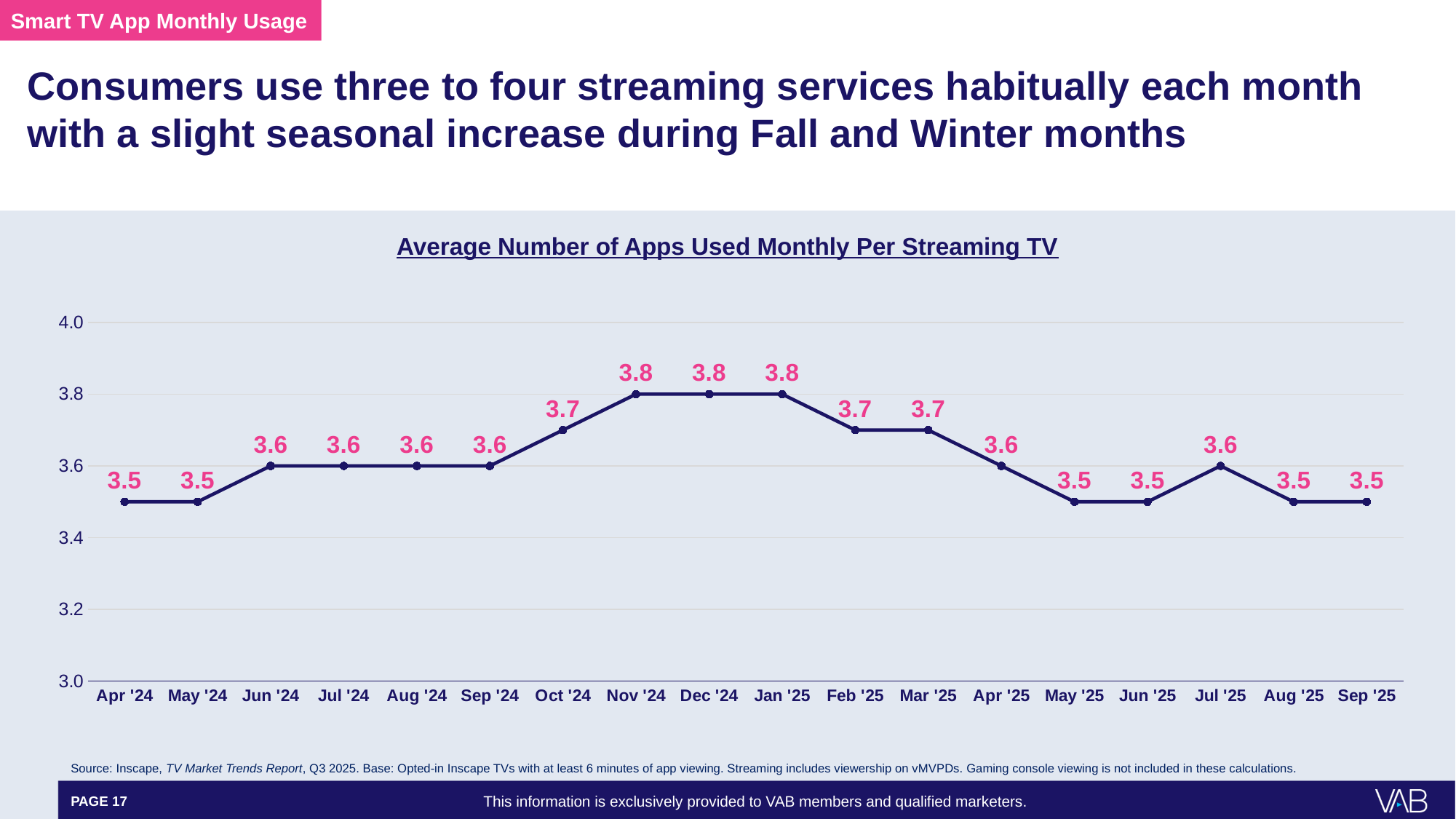
What is the difference between the value for Nov '24 and the value for Apr '24? 0.3 Is the value for Jan '25 greater or less than 3.6? greater What is the average number of apps used monthly per streaming TV in Nov '24? 3.8 Which month has a higher value, Dec '24 or Jun '25? Dec '24 What type of chart is shown on the slide? Line chart What is the value for Apr '24? 3.5 What is the value for Oct '24? 3.7 What is the value for Jul '25? 3.6 What is the lowest value plotted on the chart? 3.5 Do the values rise or fall from Apr '24 to Nov '24? Rise How many months are plotted on the chart? 18 What is the highest value plotted on the chart? 3.8